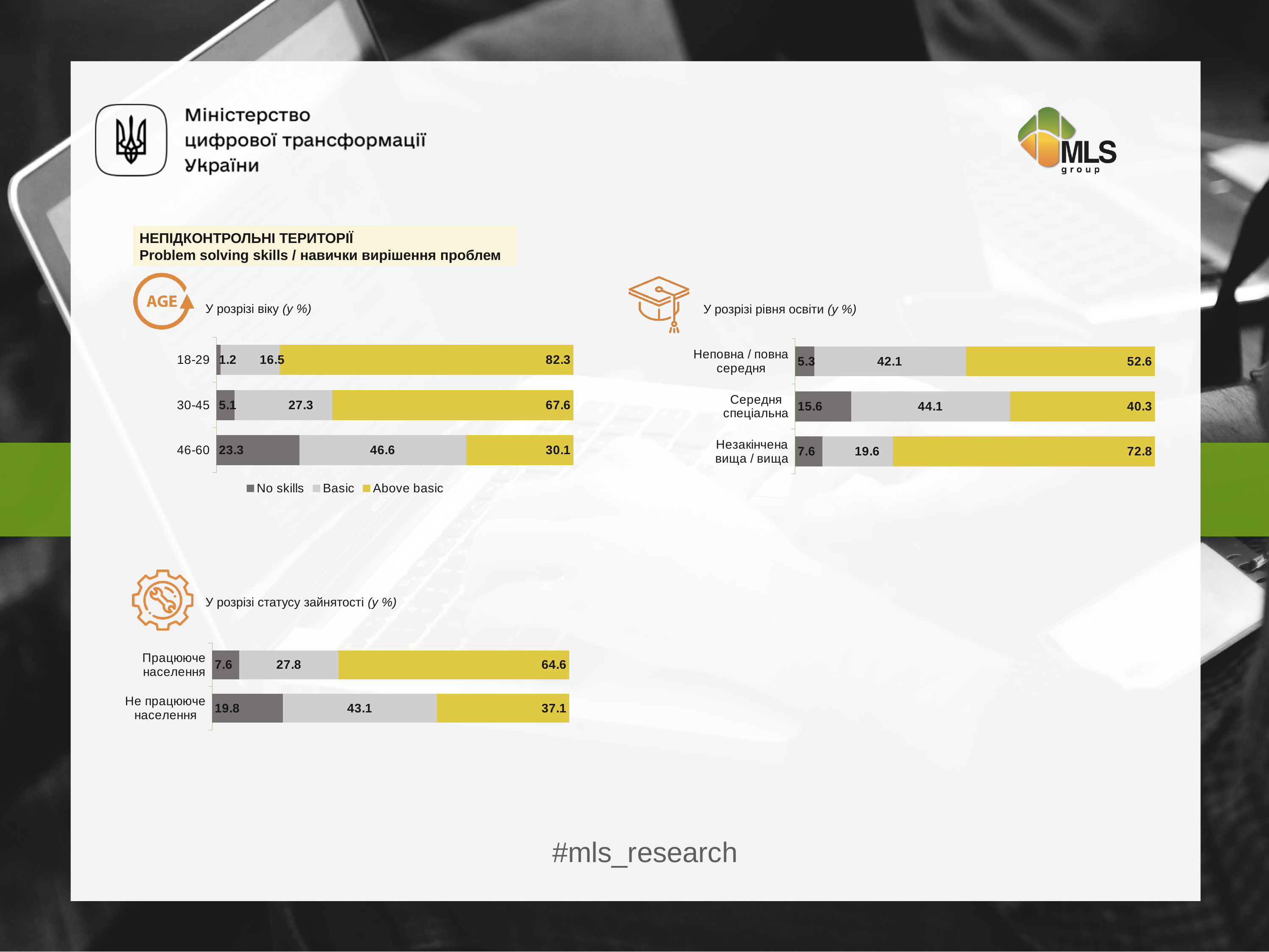
In the age chart (У розрізі віку), which age group has the highest Above basic value? 18-29 In the employment status chart (У розрізі статусу зайнятості), what is the Above basic value for Не працююче населення? 37.1 In the age chart (У розрізі віку), what is the No skills value for the 46-60 group? 23.3 In the education chart (У розрізі рівня освіти), which education level has the lowest No skills value? Неповна / повна середня In the education chart (У розрізі рівня освіти), which is larger: the Above basic value for Незакінчена вища / вища or for Неповна / повна середня? Незакінчена вища / вища In the age chart (У розрізі віку), what is the difference between the Basic values for 46-60 and 30-45? 19.3 In the employment status chart (У розрізі статусу зайнятості), how many categories are shown? 2 What type of chart is the age chart (У розрізі віку)? Stacked bar chart In the age chart (У розрізі віку), what is the Above basic value for the 18-29 group? 82.3 In the education chart (У розрізі рівня освіти), what is the Basic value for Середня спеціальна? 44.1 In the employment status chart (У розрізі статусу зайнятості), what is the difference between the No skills values for Не працююче населення and Працююче населення? 12.2 How many series does the legend under the age chart list? 3